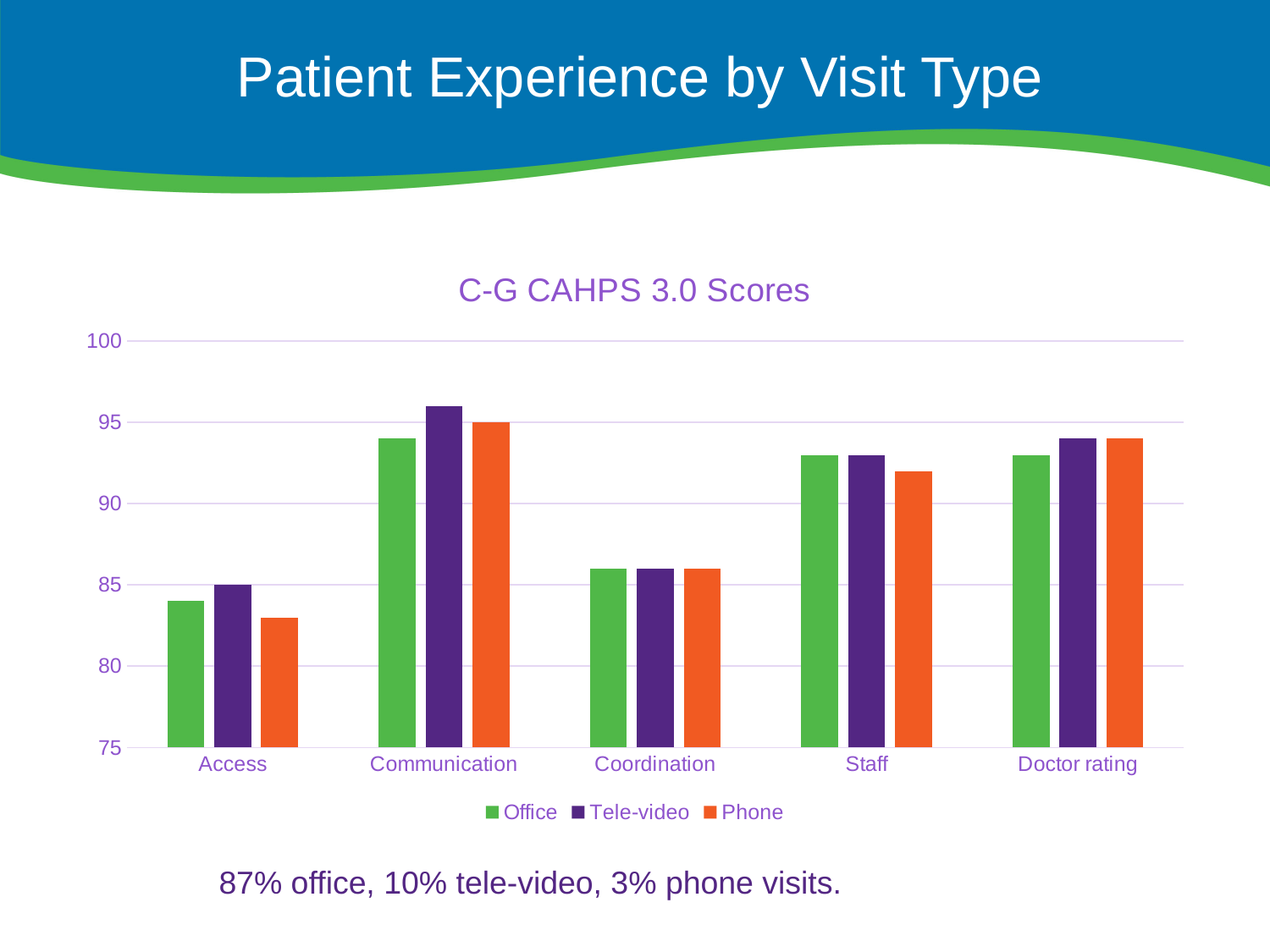
For Access, which is larger: the Tele-video score or the Phone score? Tele-video Is the Tele-video score for Communication greater or less than 95? greater What is the Tele-video score for Access? 85 Is the Office score for Access greater or less than 85? less How many series does the legend list? 3 What type of chart is shown on the slide? bar chart What is the Phone score for Communication? 95 What is the title of the chart? C-G CAHPS 3.0 Scores Which category has the lowest Phone score? Access Which category has the highest Tele-video score? Communication Is the Phone score for Staff greater or less than 90? greater How many categories are shown on the x axis? 5